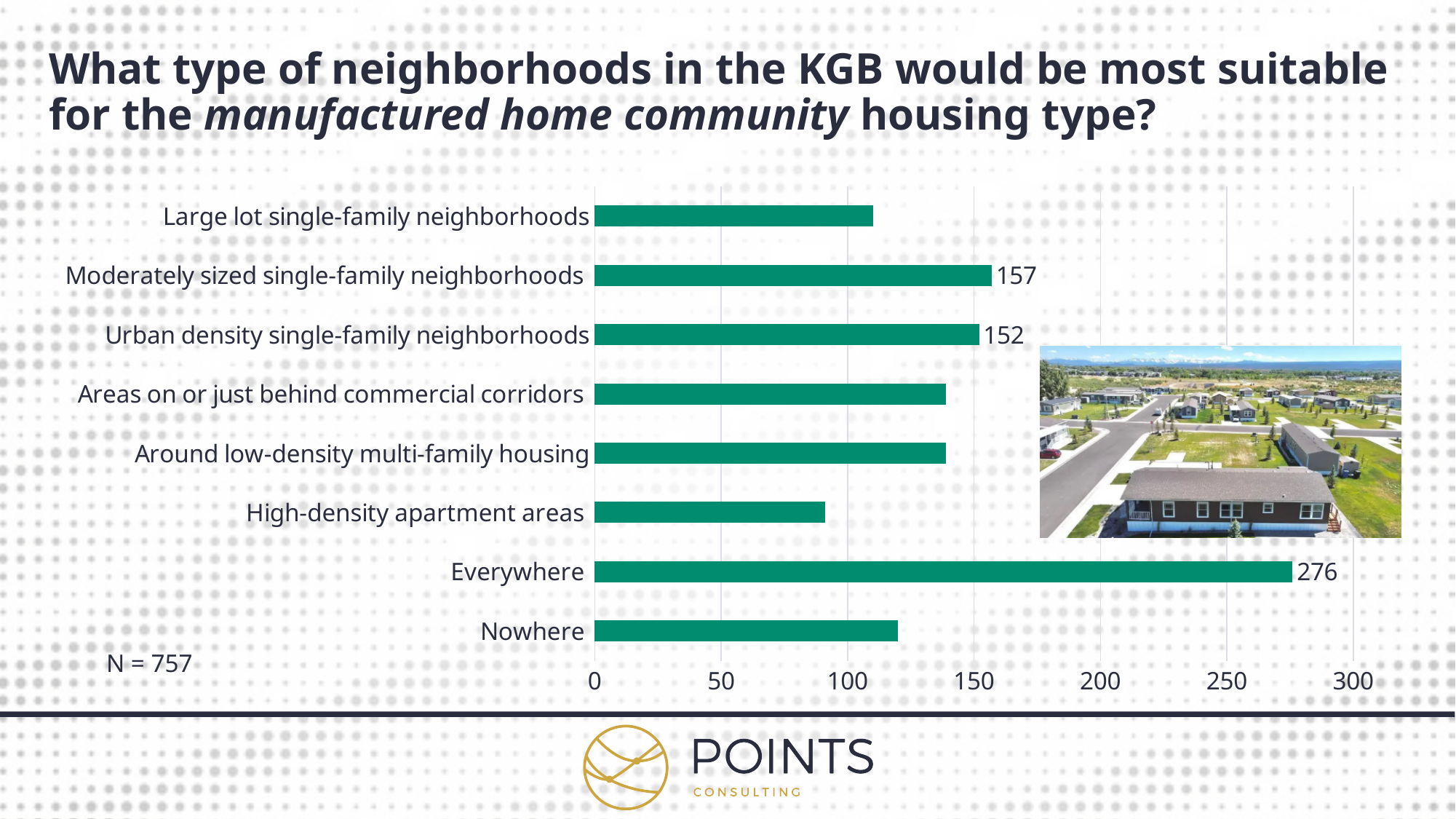
What is the value for Everywhere? 276 How many categories are shown in the chart? 8 What is the value for Moderately sized single-family neighborhoods? 157 Which category has the highest value? Everywhere What is the difference between the values for Everywhere and Moderately sized single-family neighborhoods? 119 Which is larger, the value for Everywhere or the value for Nowhere? Everywhere Is the value for Nowhere greater or less than 100? greater What kind of chart is shown on the slide? bar chart What is the difference between the values for Moderately sized single-family neighborhoods and Urban density single-family neighborhoods? 5 Is the value for High-density apartment areas greater or less than 100? less What is the value for Urban density single-family neighborhoods? 152 Which category has the lowest value? High-density apartment areas